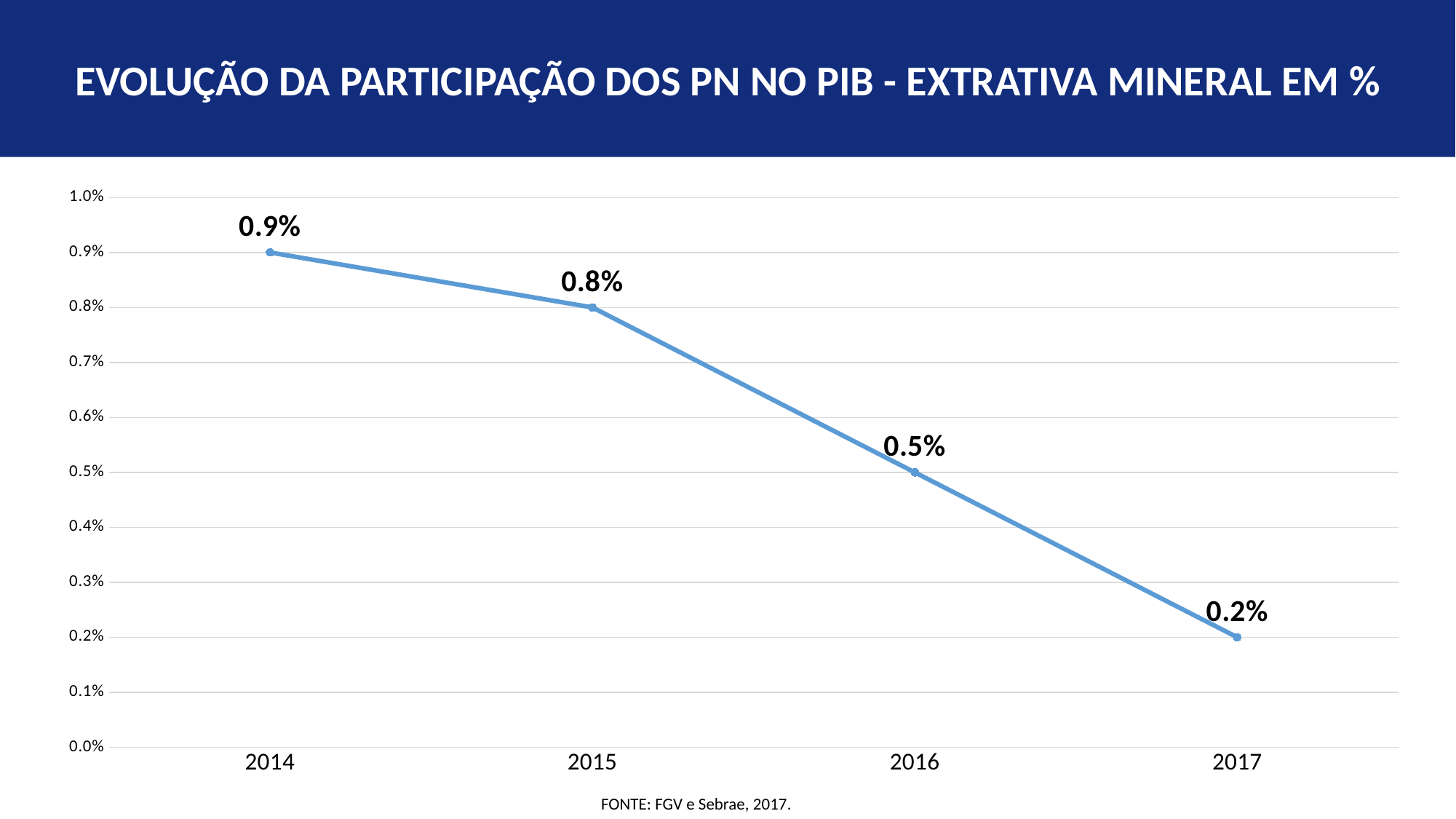
What kind of chart is shown on the slide? line chart How many years are plotted on the chart? 4 What is the value for 2016? 0.5% Which year has the highest value? 2014 What is the difference between the values for 2015 and 2016? 0.3% What is the value for 2015? 0.8% Which year has the lowest value? 2017 What is the difference between the values for 2014 and 2017? 0.7% What is the value for 2014? 0.9% What is the value for 2017? 0.2% Which is larger, the value for 2015 or the value for 2016? 2015 Do the values rise or fall from 2014 to 2017? fall